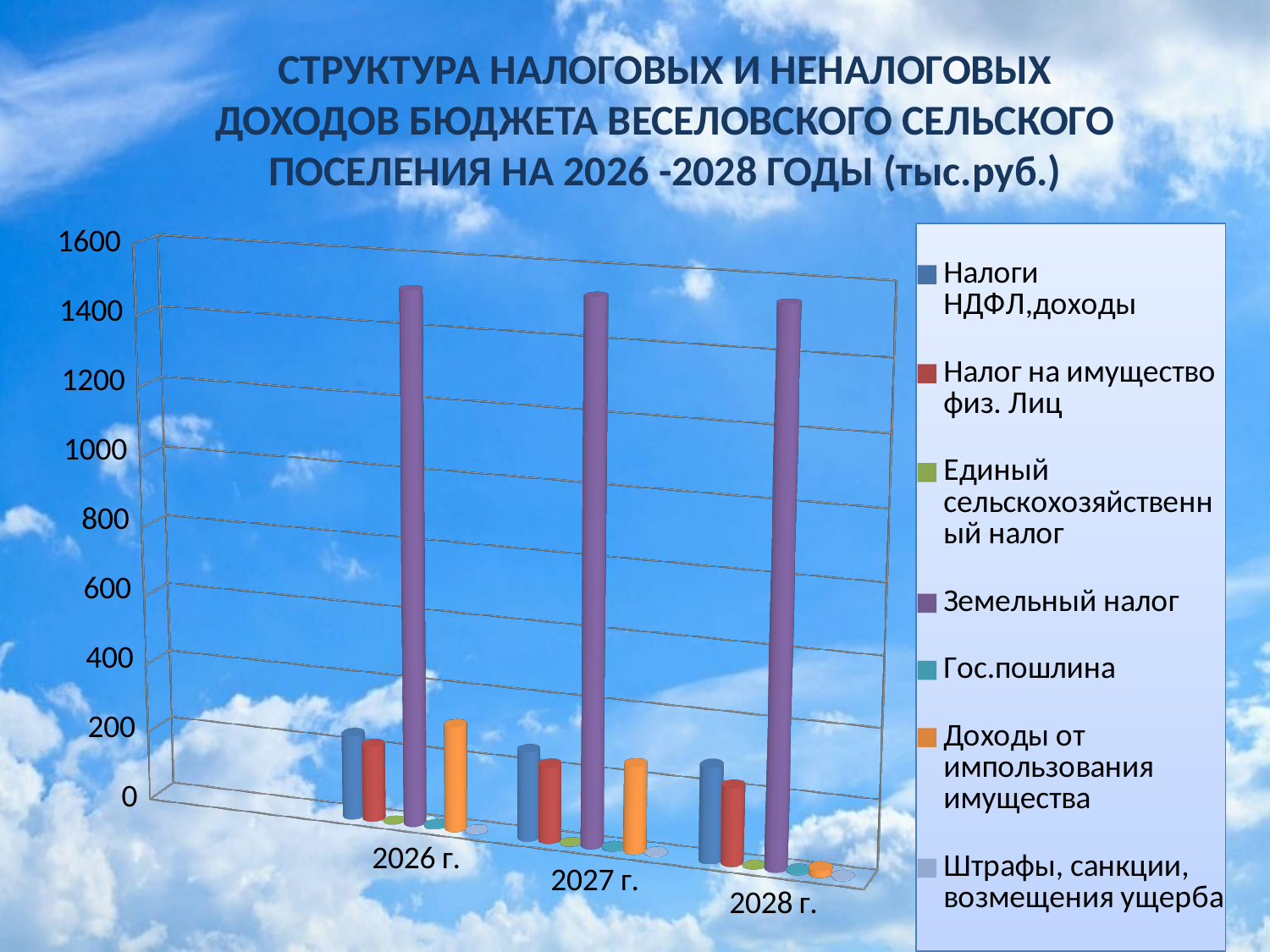
Which series has the highest value in 2026 г.? Земельный налог Which series has the highest value in 2028 г.? Земельный налог In what units are the values in the chart expressed, according to the title? тыс.руб. How many series does the legend list? 7 How many year categories are shown on the x axis? 3 What kind of chart is shown on the slide? bar chart In 2027 г., which is larger: Земельный налог or Налоги НДФЛ,доходы? Земельный налог Is the value for Налоги НДФЛ,доходы in 2026 г. greater or less than 400? less In 2026 г., which is larger: Доходы от импользования имущества or Гос.пошлина? Доходы от импользования имущества Is the value for Земельный налог in 2028 г. greater or less than 1200? greater Is the value for Земельный налог in 2026 г. greater or less than 1000? greater